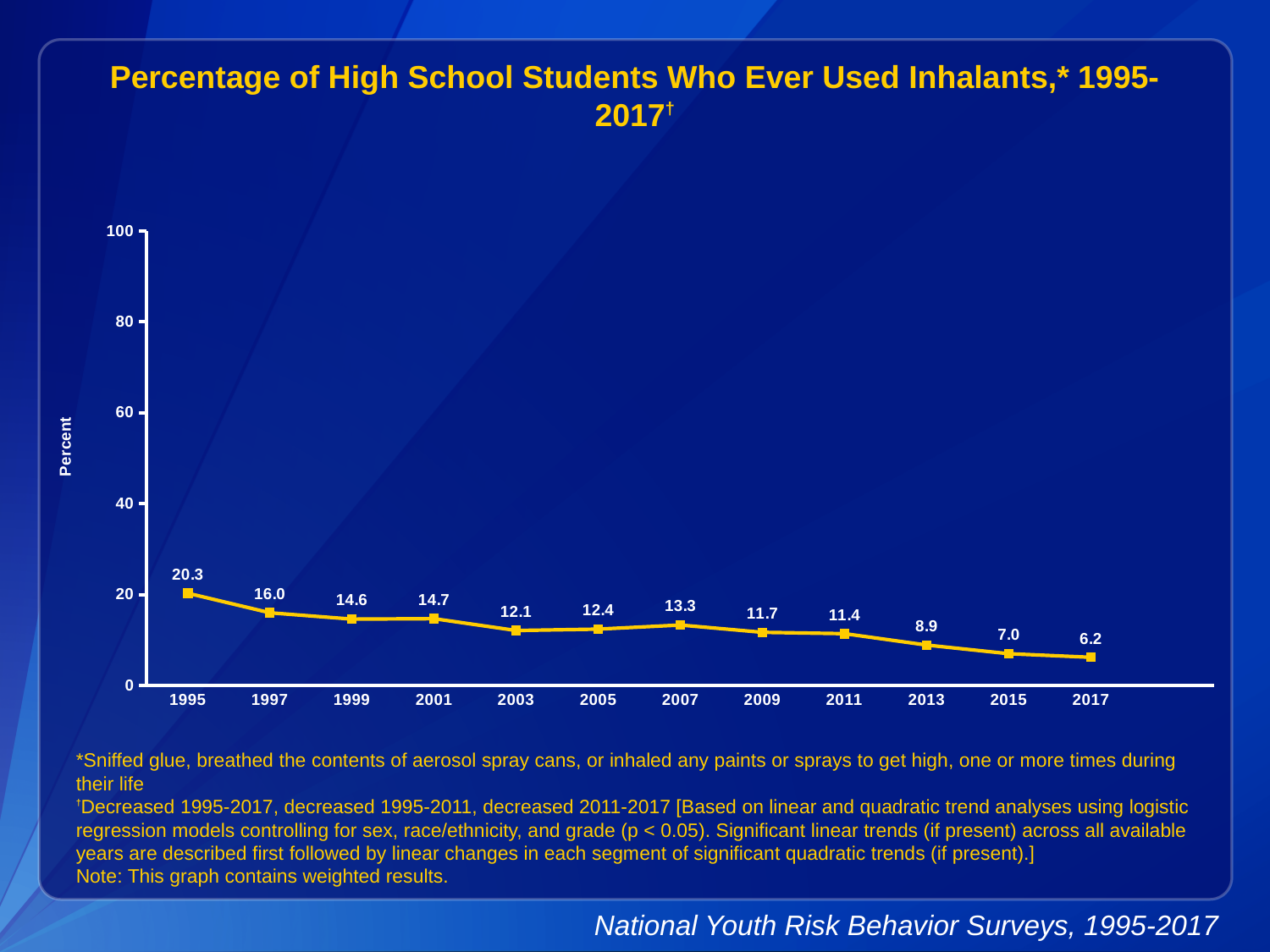
What percentage of high school students had ever used inhalants in 1995? 20.3 What is the difference between the 1995 value and the 2017 value? 14.1 Is the value for 1997 greater or less than 20? less Which year has a higher value, 2003 or 2005? 2005 What is the value plotted for 2017? 6.2 What kind of chart is shown on the slide? line chart How many years are plotted on the x axis? 12 Do the values generally rise or fall from 1995 to 2017? fall What is the value plotted for 2007? 13.3 Which year has the highest percentage of students who ever used inhalants? 1995 Which year has the lowest percentage of students who ever used inhalants? 2017 What is the label on the y axis? Percent